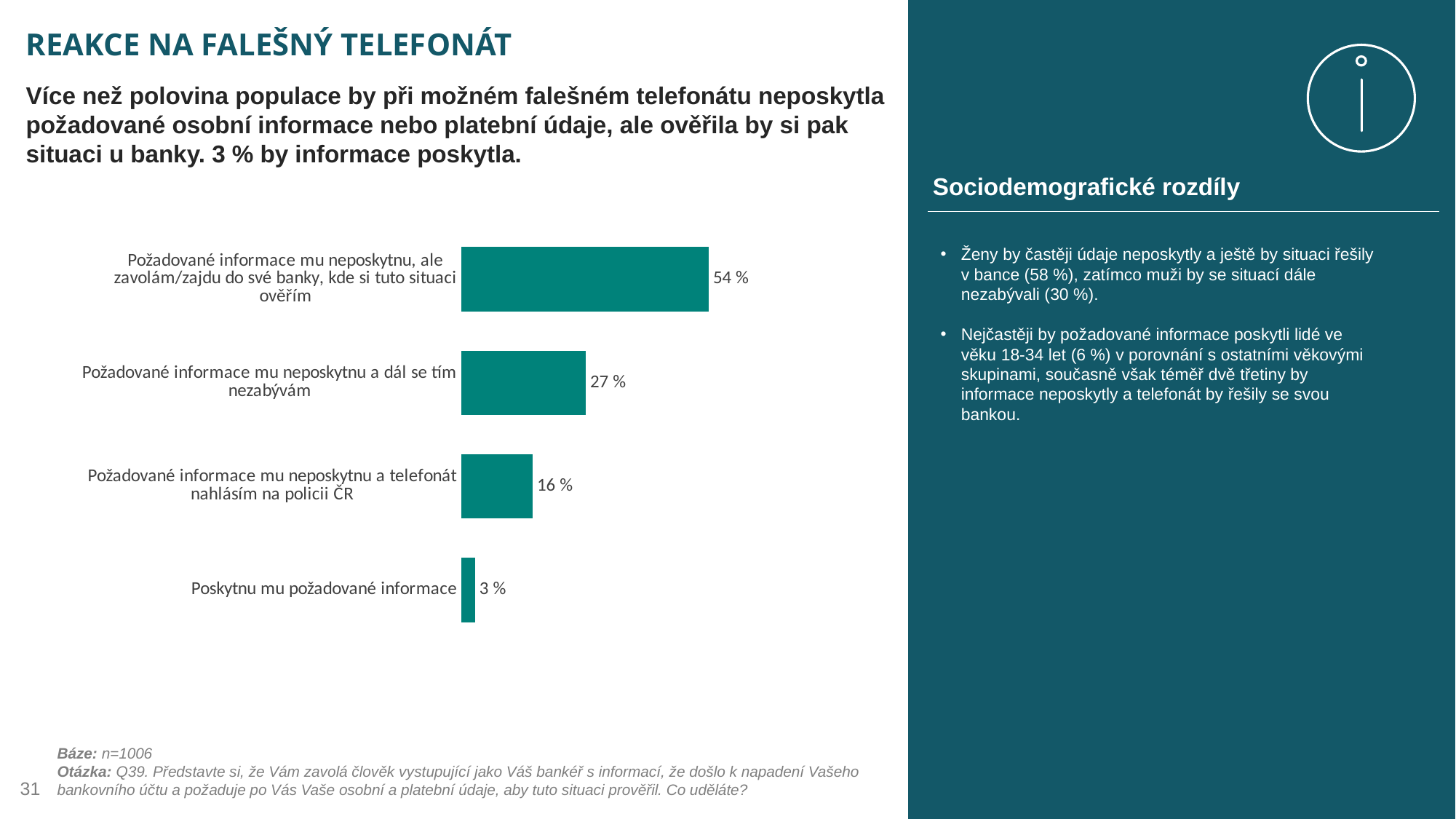
Which is larger: the value for "Požadované informace mu neposkytnu a telefonát nahlásím na policii ČR" or the value for "Poskytnu mu požadované informace"? Požadované informace mu neposkytnu a telefonát nahlásím na policii ČR Which category has the lowest value? Poskytnu mu požadované informace What is the difference between the highest and the lowest value in the chart? 51 % What is the value for "Požadované informace mu neposkytnu a telefonát nahlásím na policii ČR"? 16 % What is the value for "Poskytnu mu požadované informace"? 3 % What is the difference between the value for "Požadované informace mu neposkytnu a dál se tím nezabývám" and the value for "Požadované informace mu neposkytnu a telefonát nahlásím na policii ČR"? 11 % What is the value for "Požadované informace mu neposkytnu, ale zavolám/zajdu do své banky, kde si tuto situaci ověřím"? 54 % What kind of chart is shown on the slide? Bar chart What is the value for "Požadované informace mu neposkytnu a dál se tím nezabývám"? 27 % How many categories are shown in the chart? 4 What colour are the bars in the chart? Teal Which category has the highest value? Požadované informace mu neposkytnu, ale zavolám/zajdu do své banky, kde si tuto situaci ověřím